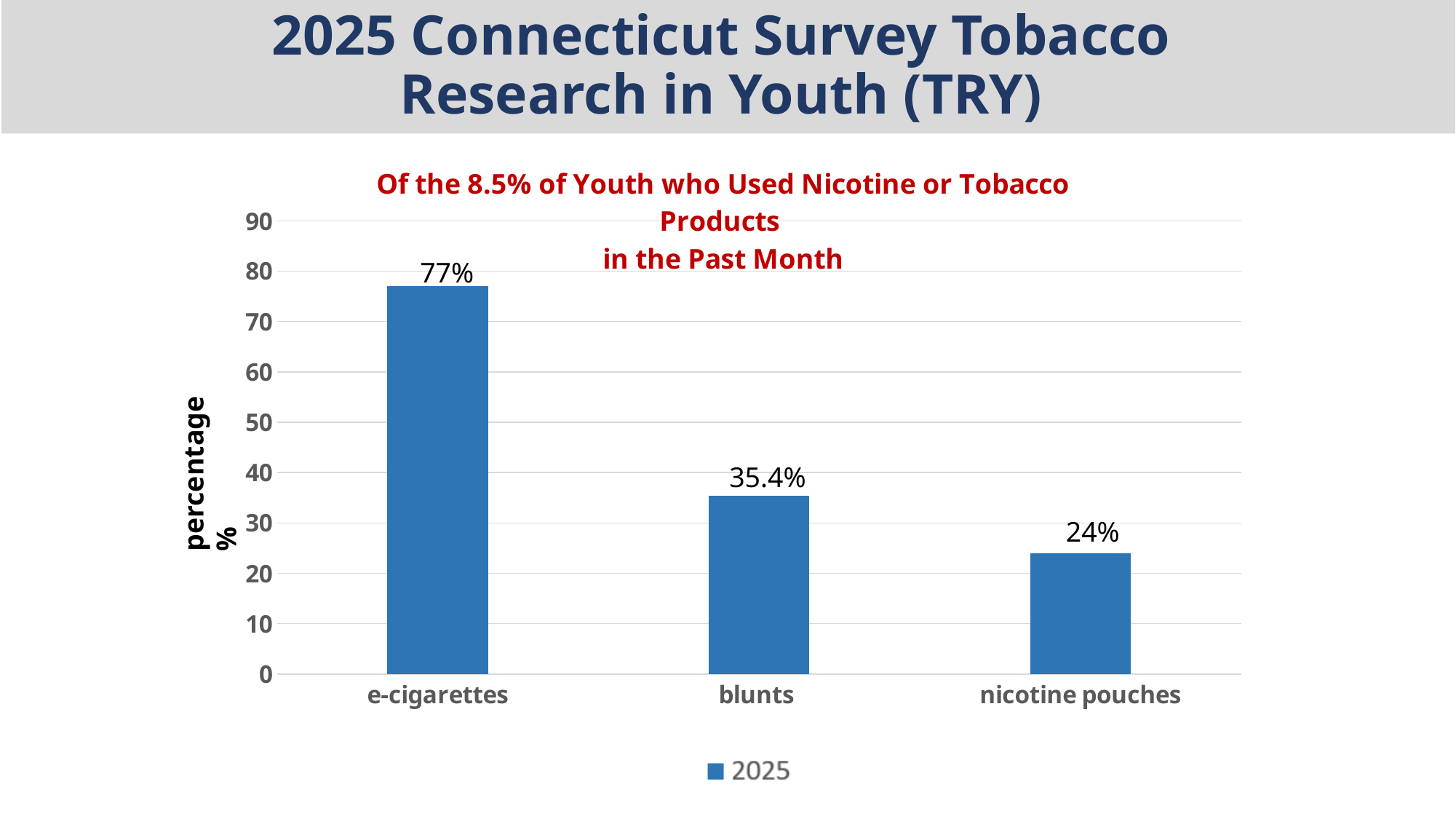
What is the difference between the values for blunts and nicotine pouches? 11.4% What kind of chart is shown on the slide? bar chart What is the difference between the values for e-cigarettes and nicotine pouches? 53% How many categories are shown on the x axis? 3 Which category has the highest value? e-cigarettes Which is larger, the value for blunts or the value for nicotine pouches? blunts What is the value for e-cigarettes? 77% Is the value for blunts greater or less than 40? less What is the value for blunts? 35.4% What series does the legend list? 2025 What is the value for nicotine pouches? 24% Which category has the lowest value? nicotine pouches